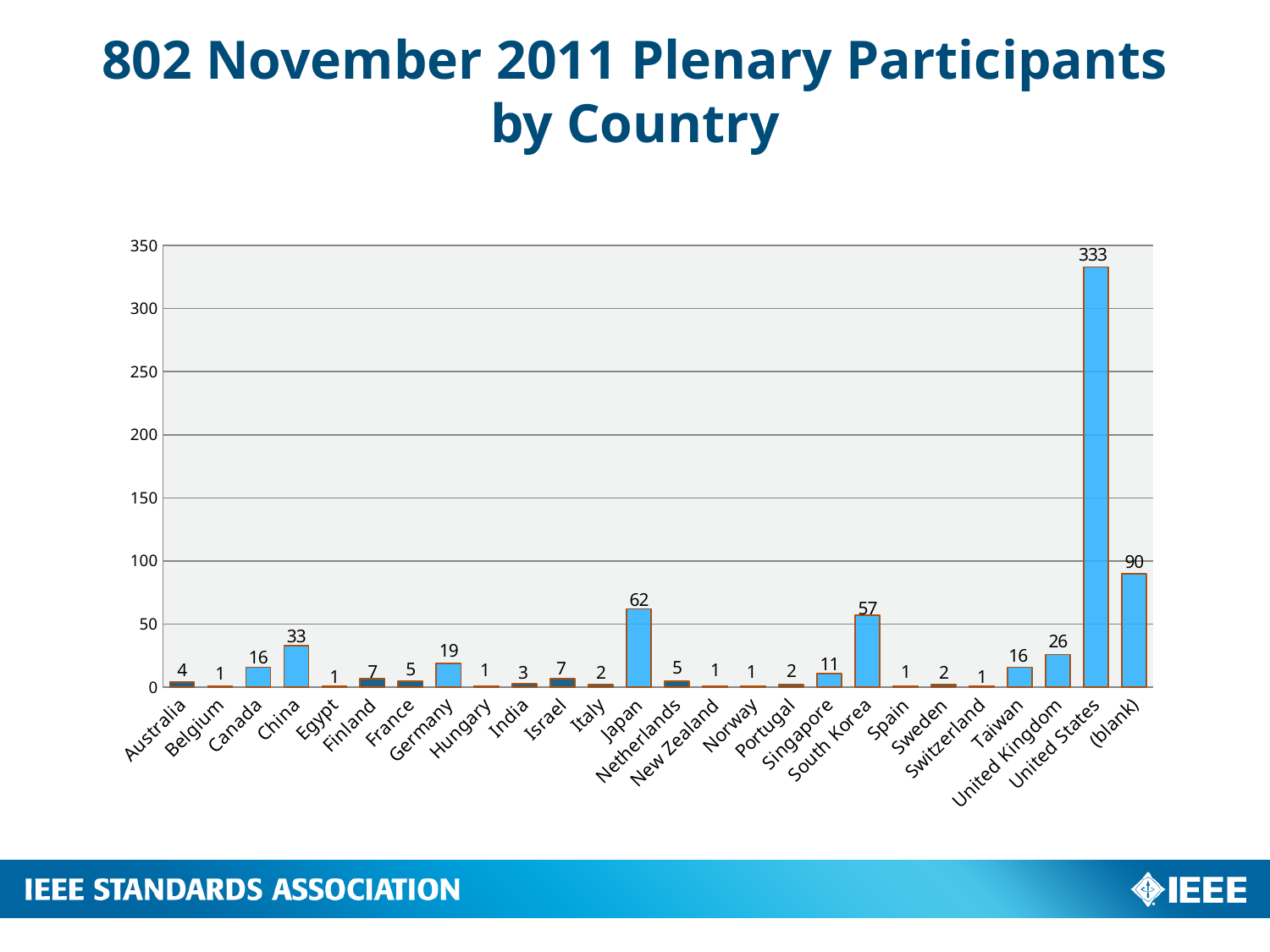
Which country has the highest number of participants? United States What is the value for Japan? 62 What kind of chart is shown on the slide? bar chart What is the difference between the values for United States and (blank)? 243 Is the value for United States greater or less than 300? greater What is the title of the chart? 802 November 2011 Plenary Participants by Country What is the difference between the values for Japan and South Korea? 5 What is the value for South Korea? 57 What is the value for (blank)? 90 Which is larger, the value for China or the value for United Kingdom? China What is the value for United States? 333 How many categories are shown on the x axis? 26